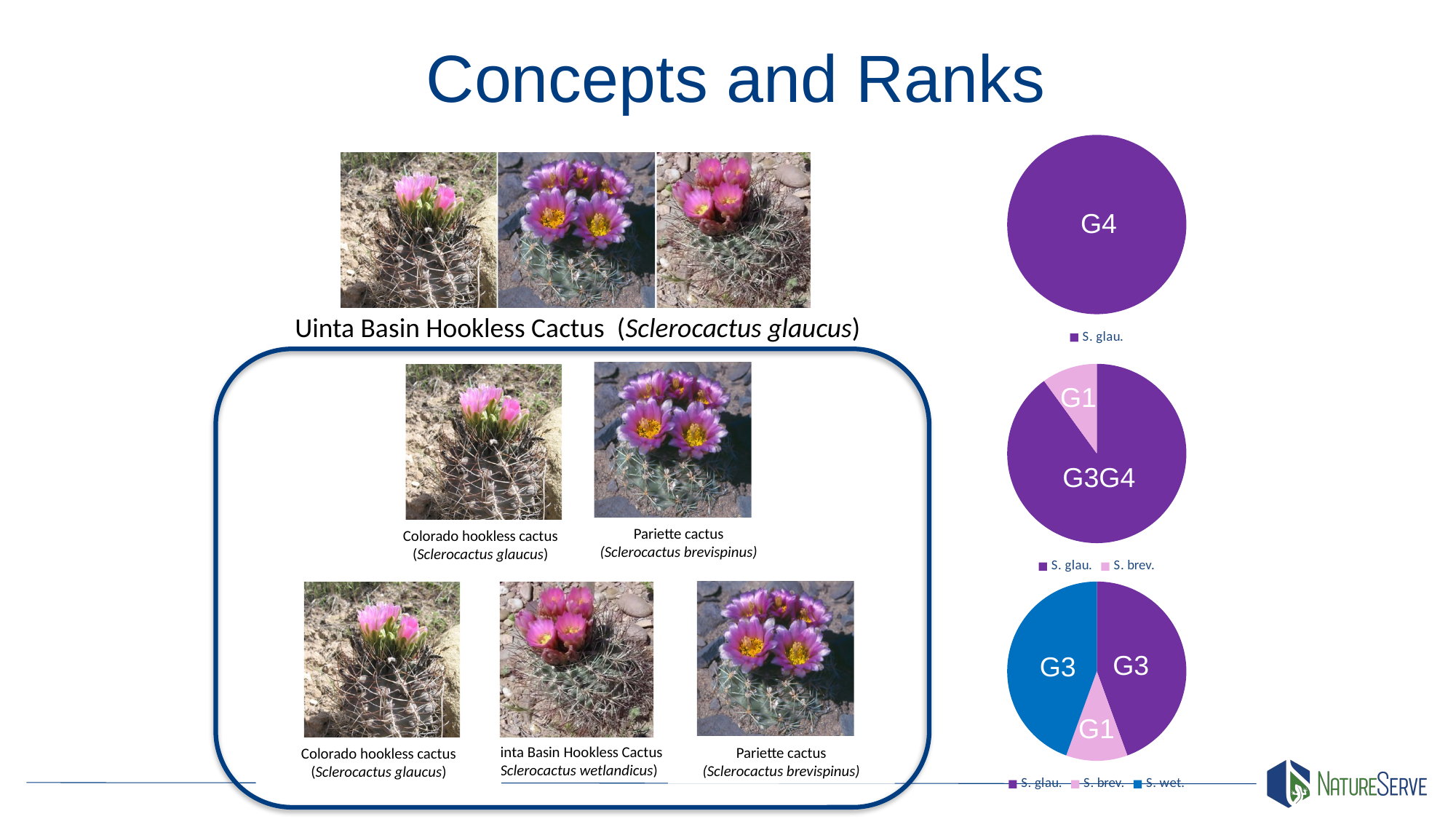
What rank label is printed on the single slice of the top pie chart? G4 What kind of chart is the top chart on the right side of the slide? pie chart In the middle pie chart, which series has the larger slice, S. glau. or S. brev.? S. glau. In the bottom pie chart, which series has the smallest slice? S. brev. How many series does the legend of the top pie chart list? 1 What rank label is printed on the S. brev. slice of the bottom pie chart? G1 What rank label is printed on the S. glau. slice of the middle pie chart? G3G4 How many slices does the bottom pie chart have? 3 What colour is the S. wet. slice in the bottom pie chart? blue In the middle pie chart, which series has the smallest slice? S. brev. How many series does the legend of the middle pie chart list? 2 How many series does the legend of the bottom pie chart list? 3